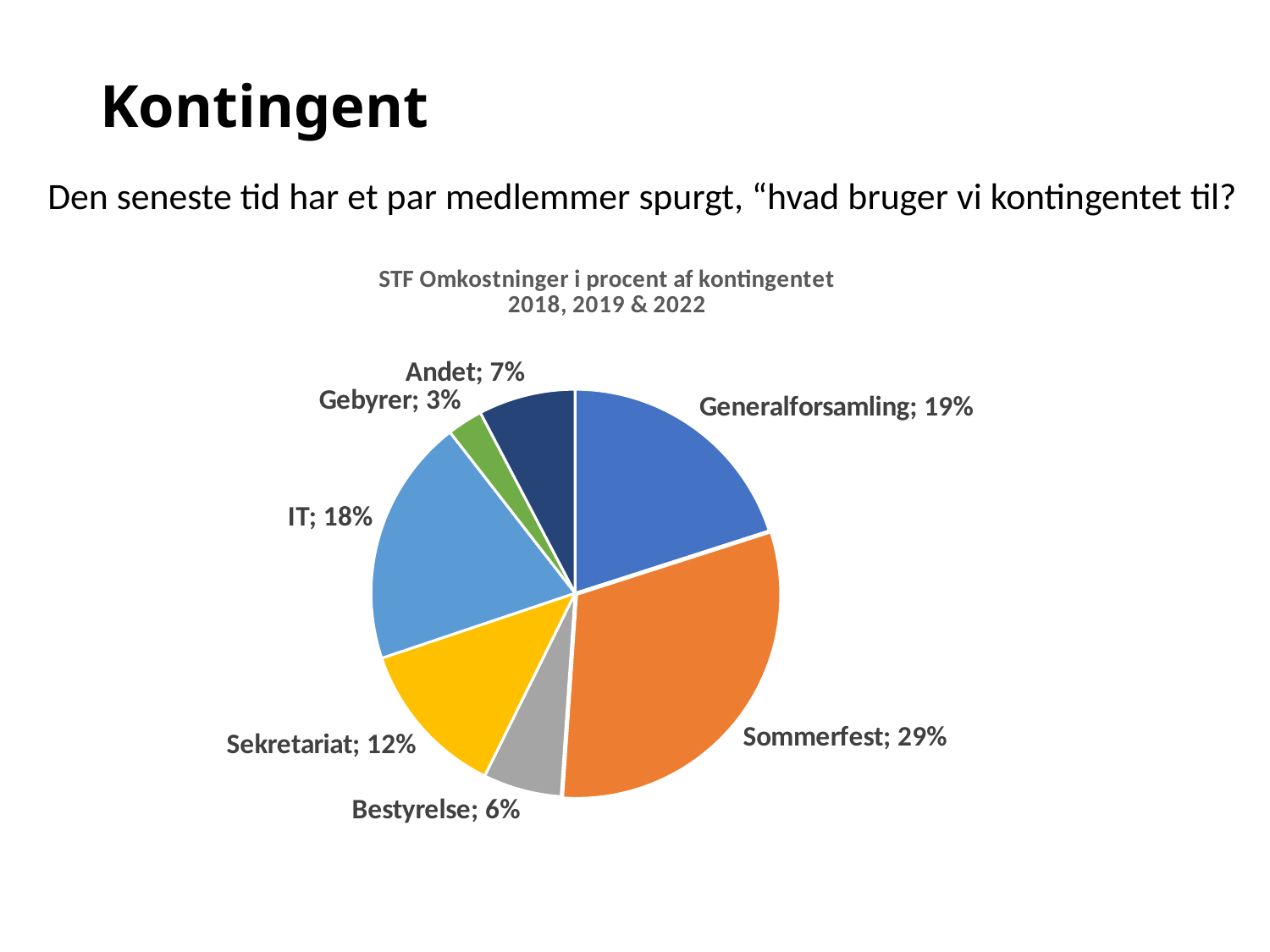
What is the difference between the values for Sommerfest and Generalforsamling? 10% What is the value for Generalforsamling? 19% What is the title of the chart? STF Omkostninger i procent af kontingentet 2018, 2019 & 2022 What is the value for IT? 18% Which category has the smallest slice of the pie? Gebyrer What kind of chart is shown on the slide? pie chart Which is larger, the value for Andet or the value for Bestyrelse? Andet What is the difference between the values for Sekretariat and Gebyrer? 9% Which category has the largest slice of the pie? Sommerfest What is the value for Sekretariat? 12% How many categories are shown in the pie chart? 7 What share of the pie does Sommerfest take? 29%